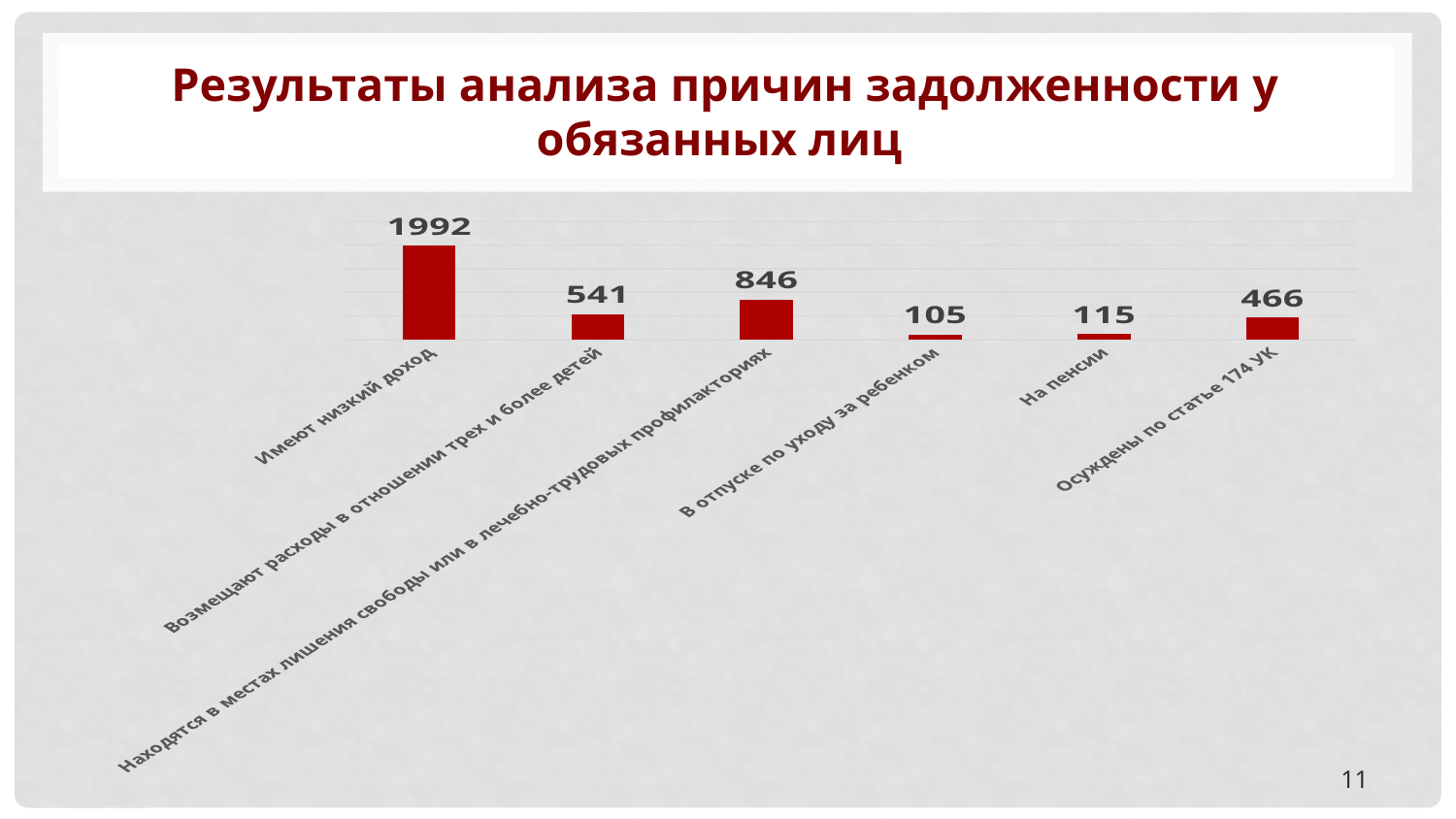
What is the title of the slide containing the chart? Результаты анализа причин задолженности у обязанных лиц What is the value for "Осуждены по статье 174 УК"? 466 Which category has the highest value? Имеют низкий доход What is the value for "На пенсии"? 115 Which category has the lowest value? В отпуске по уходу за ребенком What kind of chart is shown on the slide? Bar chart What is the value for "Имеют низкий доход"? 1992 What is the difference between the values for "Имеют низкий доход" and "Находятся в местах лишения свободы или в лечебно-трудовых профилакториях"? 1146 What is the difference between the values for "Возмещают расходы в отношении трех и более детей" and "Осуждены по статье 174 УК"? 75 How many categories are shown in the chart? 6 What is the value for "Находятся в местах лишения свободы или в лечебно-трудовых профилакториях"? 846 Which is larger: the value for "Возмещают расходы в отношении трех и более детей" or the value for "Осуждены по статье 174 УК"? Возмещают расходы в отношении трех и более детей